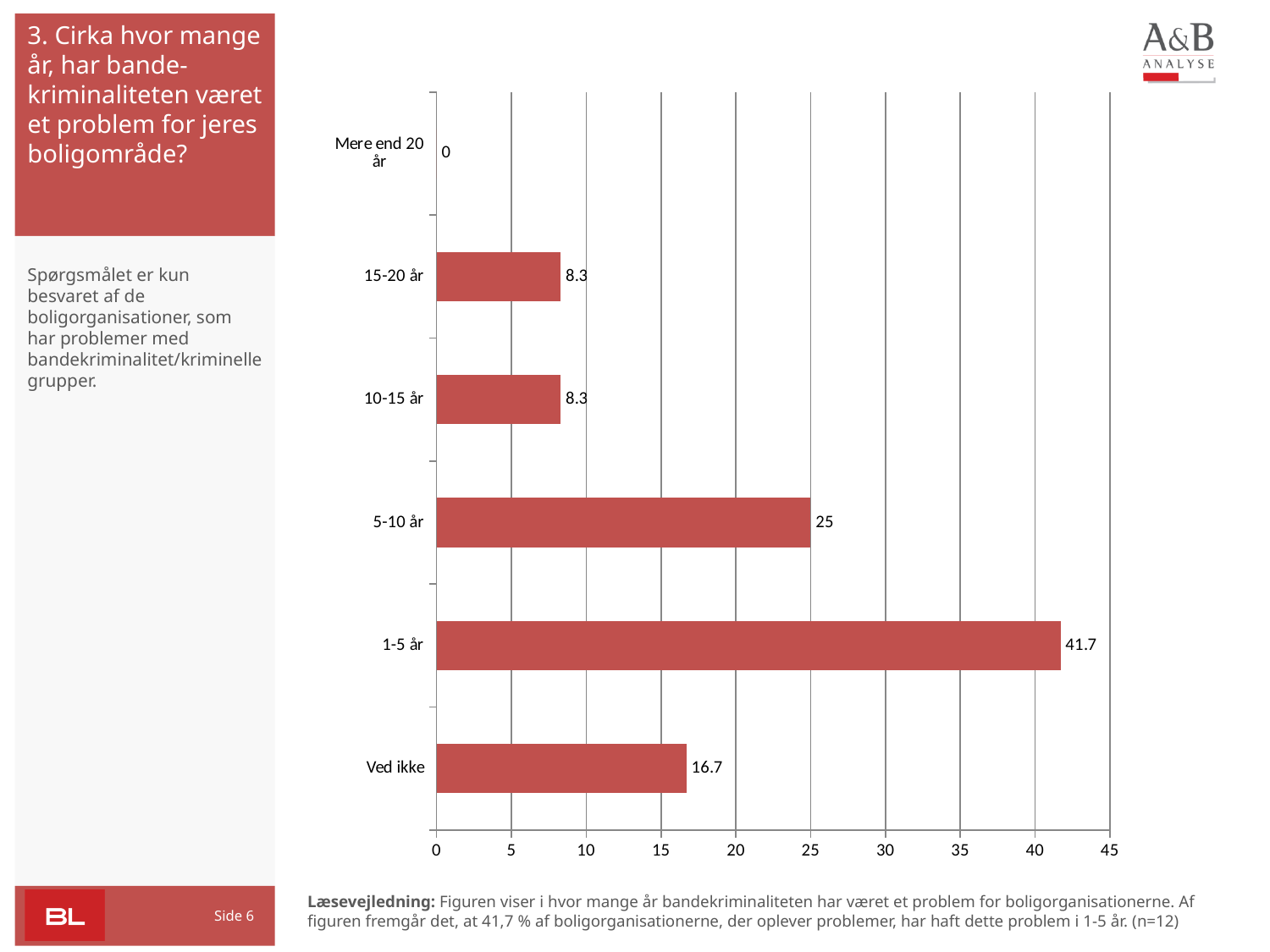
What is the value for the '5-10 år' category? 25 Is the value for '1-5 år' greater or less than 40? greater Which category has the lowest value? Mere end 20 år What is the value for the '1-5 år' category? 41.7 How many categories are shown on the chart? 6 Which is larger, the value for 'Ved ikke' or the value for '10-15 år'? Ved ikke What is the value for the 'Ved ikke' category? 16.7 What is the maximum value shown on the horizontal axis? 45 What is the value for the 'Mere end 20 år' category? 0 Which category has the highest value? 1-5 år What kind of chart is shown on the slide? bar chart What is the difference between the values for '1-5 år' and '5-10 år'? 16.7